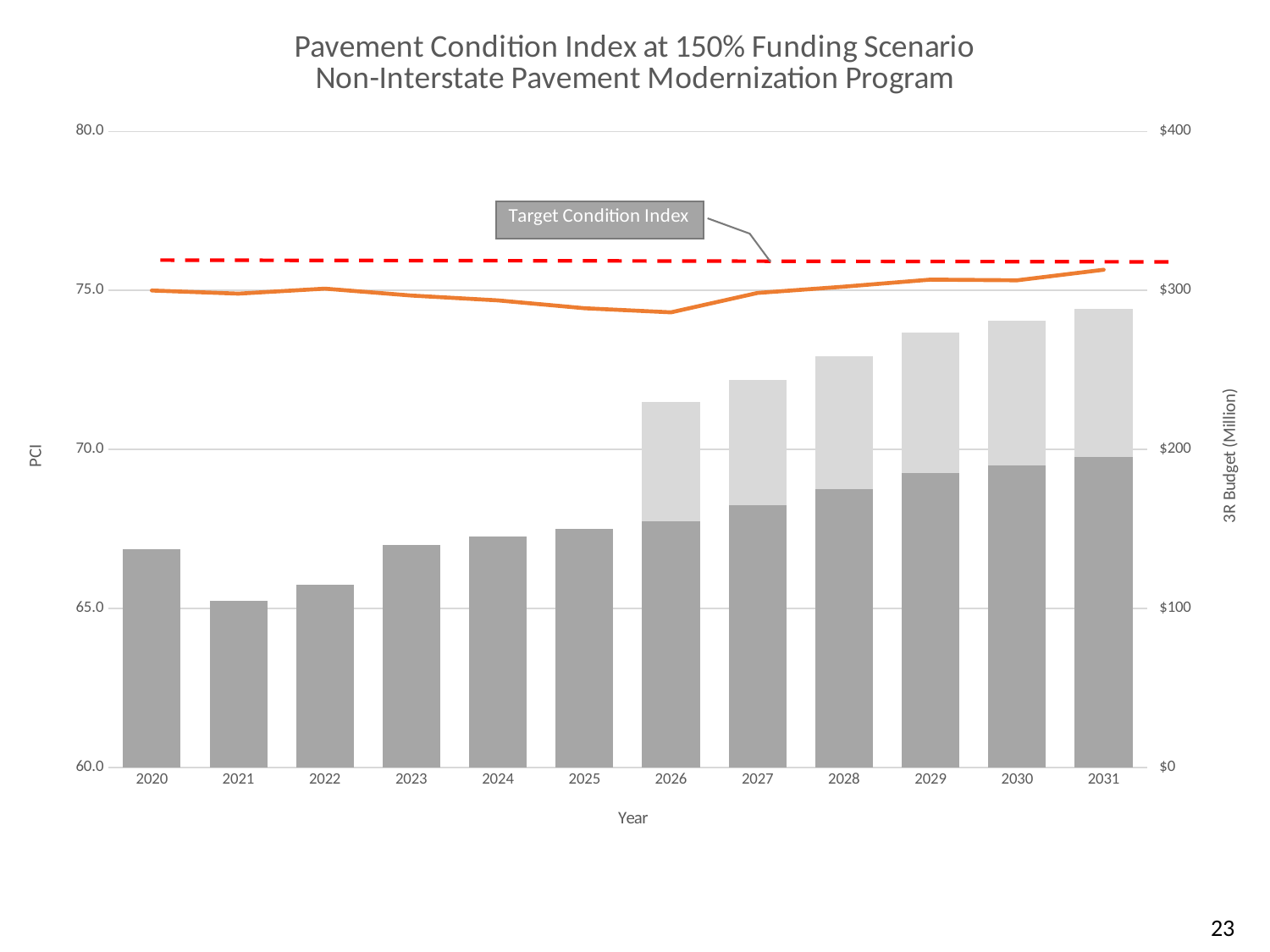
Is the dark gray bar for 2020 greater or less than $100 million? greater Is the total stacked bar for 2026 greater or less than $200 million? greater Do the stacked bars rise or fall from 2026 to 2031? rise Which year has the lowest dark gray bar? 2021 What is the label of the right-hand vertical axis? 3R Budget (Million) What kind of chart is shown on the slide? A combination bar and line chart Which year has the lowest value on the orange PCI line? 2026 What is the title of the chart? Pavement Condition Index at 150% Funding Scenario Non-Interstate Pavement Modernization Program Is the total stacked bar for 2031 greater or less than $300 million? less Which year has the tallest stacked bar overall? 2031 How many years are shown on the x axis? 12